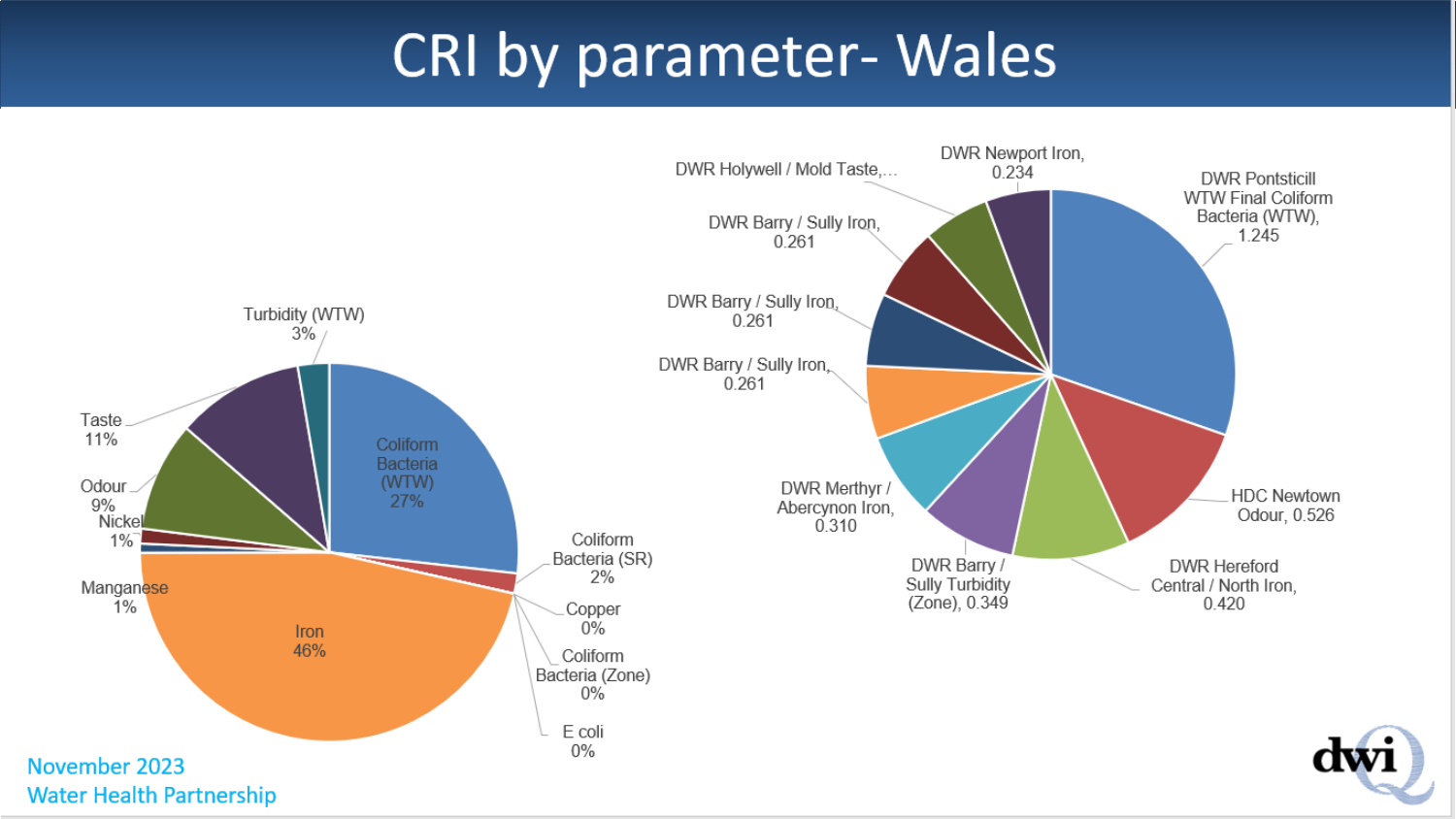
In the left pie chart, which has the larger share, Taste or Odour? Taste In the right pie chart, what is the difference between DWR Hereford Central / North Iron and DWR Merthyr / Abercynon Iron? 0.110 In the left pie chart, what is the difference in percentage points between Iron and Coliform Bacteria (WTW)? 19 In the left pie chart, what percentage is shown for Coliform Bacteria (WTW)? 27% In the left pie chart, which parameter has the largest share? Iron In the left pie chart, what percentage is shown for Turbidity (WTW)? 3% In the right pie chart, which slice has the largest value? DWR Pontsticill WTW Final Coliform Bacteria (WTW) In the right pie chart, what value is shown for HDC Newtown Odour? 0.526 What type of chart is used on this slide? Pie chart How many slices (parameters) are labelled in the left pie chart? 11 In the right pie chart, what value is shown for DWR Newport Iron? 0.234 In the left pie chart, what percentage is shown for Iron? 46%